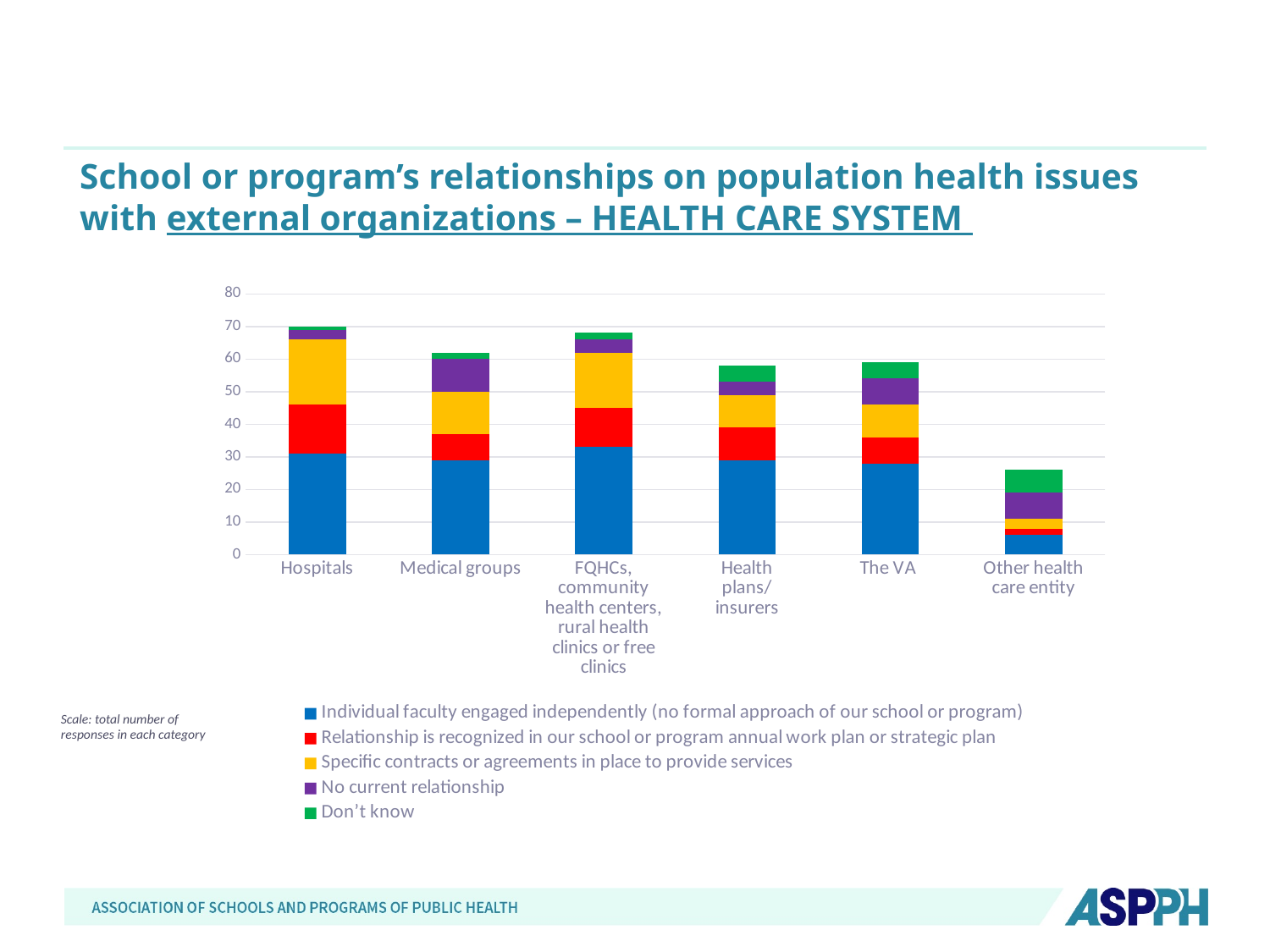
What is the maximum value shown on the y axis? 80 Is the 'Individual faculty engaged independently' value for Other health care entity greater or less than 10? less Is the total for Hospitals greater or less than 60? greater What kind of chart is shown on the slide? stacked bar chart Is the total for The VA greater or less than 50? greater Which colour represents 'Don't know' in the legend? green Which has a larger total: The VA or Other health care entity? The VA Which has a larger total: Hospitals or Medical groups? Hospitals Which category has the lowest total number of responses? Other health care entity How many categories are shown along the x axis of the chart? 6 How many series does the chart's legend list? 5